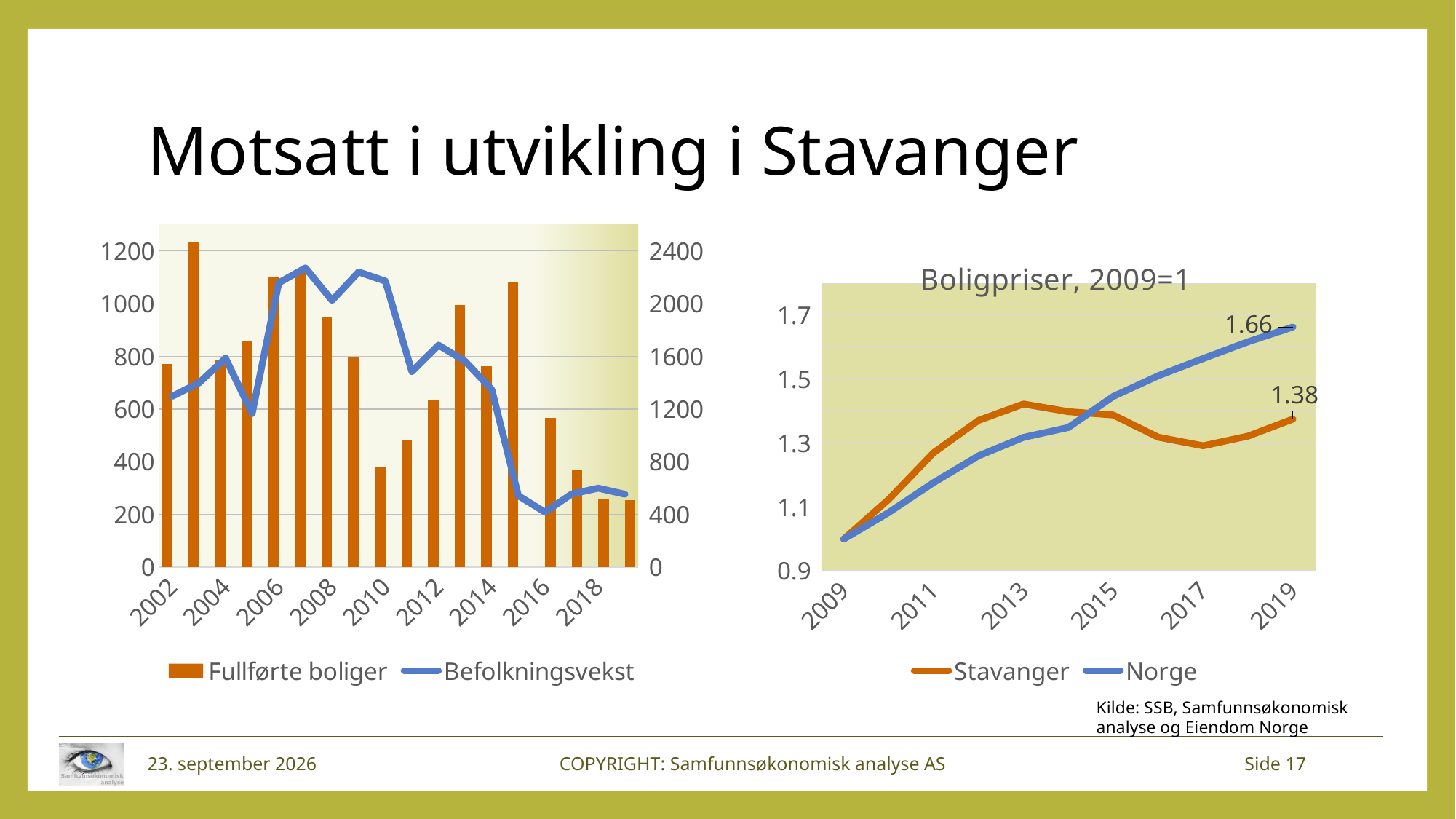
On the left chart, which year has the highest bar for Fullførte boliger? 2003 On the right chart titled 'Boligpriser, 2009=1', does the Norge line rise or fall from 2009 to 2019? Rise On the right chart titled 'Boligpriser, 2009=1', which series has the higher value in 2019, Stavanger or Norge? Norge On the right chart titled 'Boligpriser, 2009=1', what kind of chart is it? Line chart On the right chart titled 'Boligpriser, 2009=1', what is the value for Stavanger in 2019? 1.38 On the right chart titled 'Boligpriser, 2009=1', what is the difference between the Norge and Stavanger values in 2019? 0.28 On the left chart, how many bars for Fullførte boliger are plotted? 18 On the left chart, what are the two series listed in the legend? Fullførte boliger and Befolkningsvekst On the right chart titled 'Boligpriser, 2009=1', how many series does the legend list? 2 On the left chart, is the Fullførte boliger bar for 2015 greater or less than 1000? greater On the right chart titled 'Boligpriser, 2009=1', what is the value for Norge in 2019? 1.66 On the right chart titled 'Boligpriser, 2009=1', is the value for Stavanger in 2013 greater or less than 1.3? greater